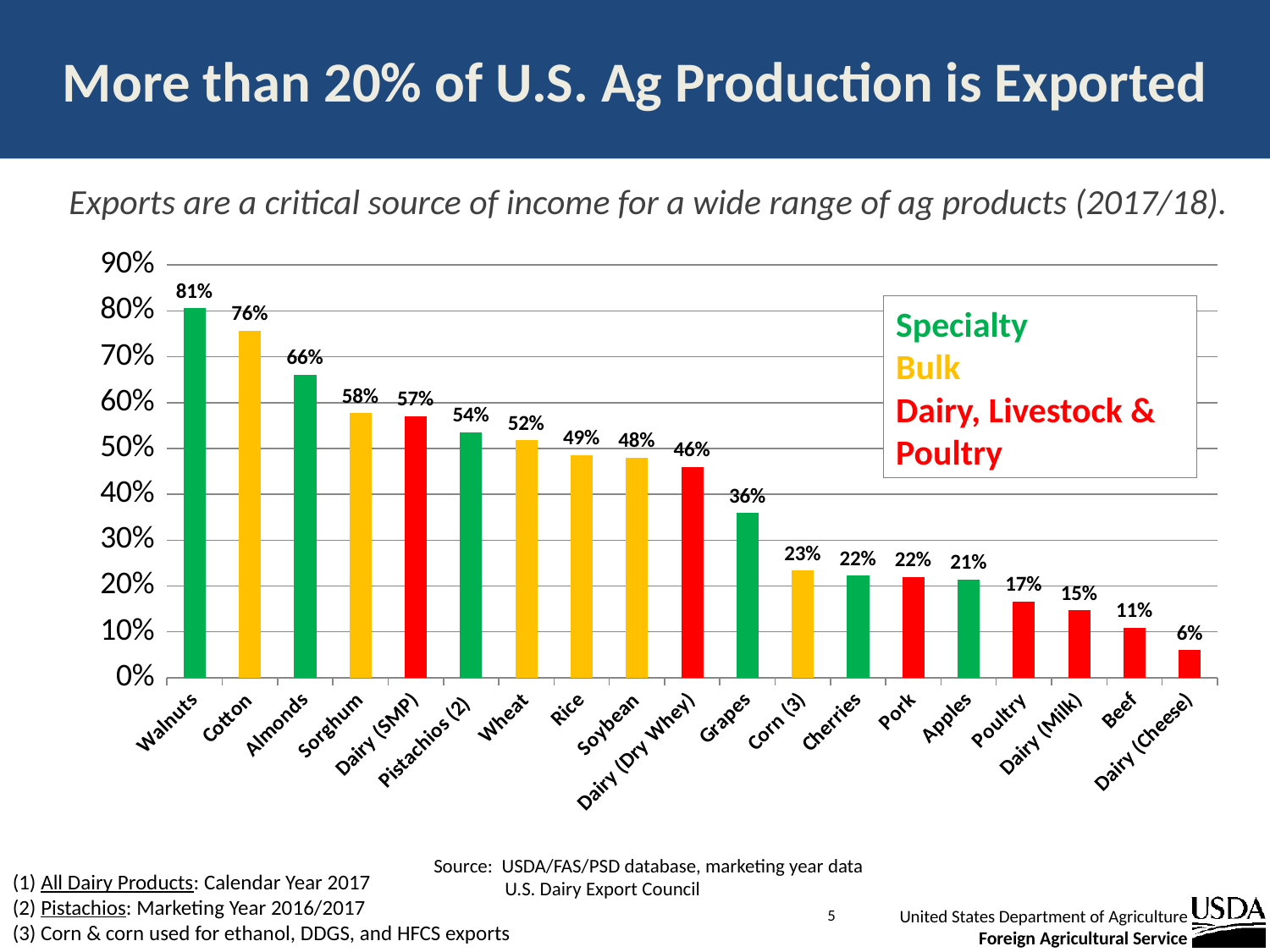
What value is shown for Dairy (Milk)? 15% How many products are shown on the x axis of the chart? 19 According to the legend, what category do the red bars represent? Dairy, Livestock & Poultry Is the value for Rice greater or less than 40%? greater What type of chart is used on this slide? Bar chart What percentage of U.S. walnut production is exported according to the chart? 81% What is the export share shown for Soybean? 48% Which product has the highest export share in the chart? Walnuts Do the values rise or fall moving from left to right along the x axis? Fall Which has a larger export share, Grapes or Corn (3)? Grapes Which product has the lowest export share in the chart? Dairy (Cheese) What is the difference between the export shares of Cotton and Almonds? 10%